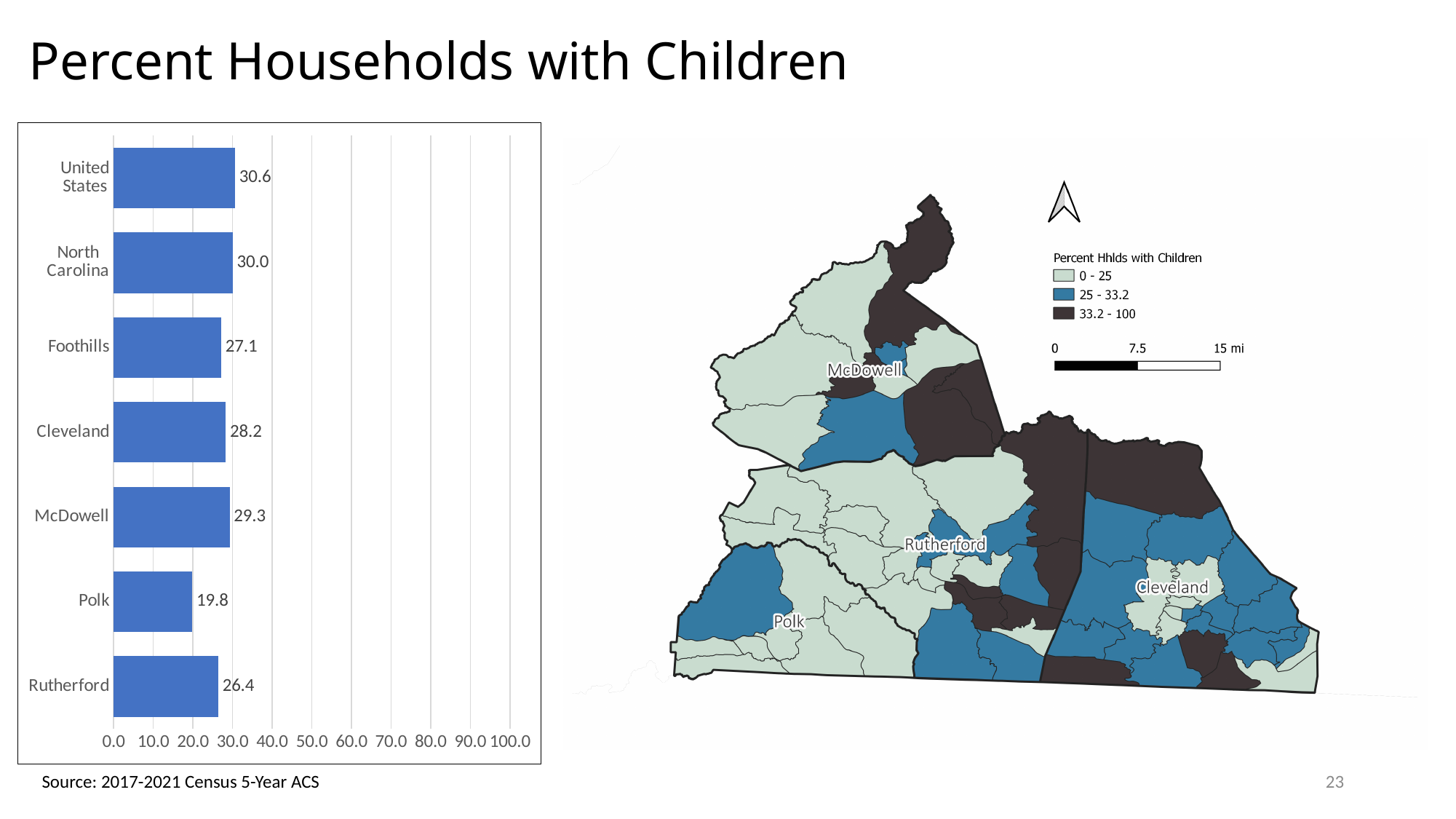
What is the value for McDowell in the bar chart? 29.3 How many categories are shown in the bar chart? 7 What is the value for Polk in the bar chart? 19.8 Which category has the lowest value in the bar chart? Polk What is the title of the slide? Percent Households with Children What is the difference between the values for Cleveland and Rutherford in the bar chart? 1.8 What is the difference between the values for North Carolina and Foothills in the bar chart? 2.9 Which has a larger value in the bar chart, McDowell or Foothills? McDowell Which category has the highest value in the bar chart? United States Is the value for Polk in the bar chart greater or less than 20.0? less What kind of chart is shown on the left of the slide? bar chart What is the value for the United States in the bar chart? 30.6